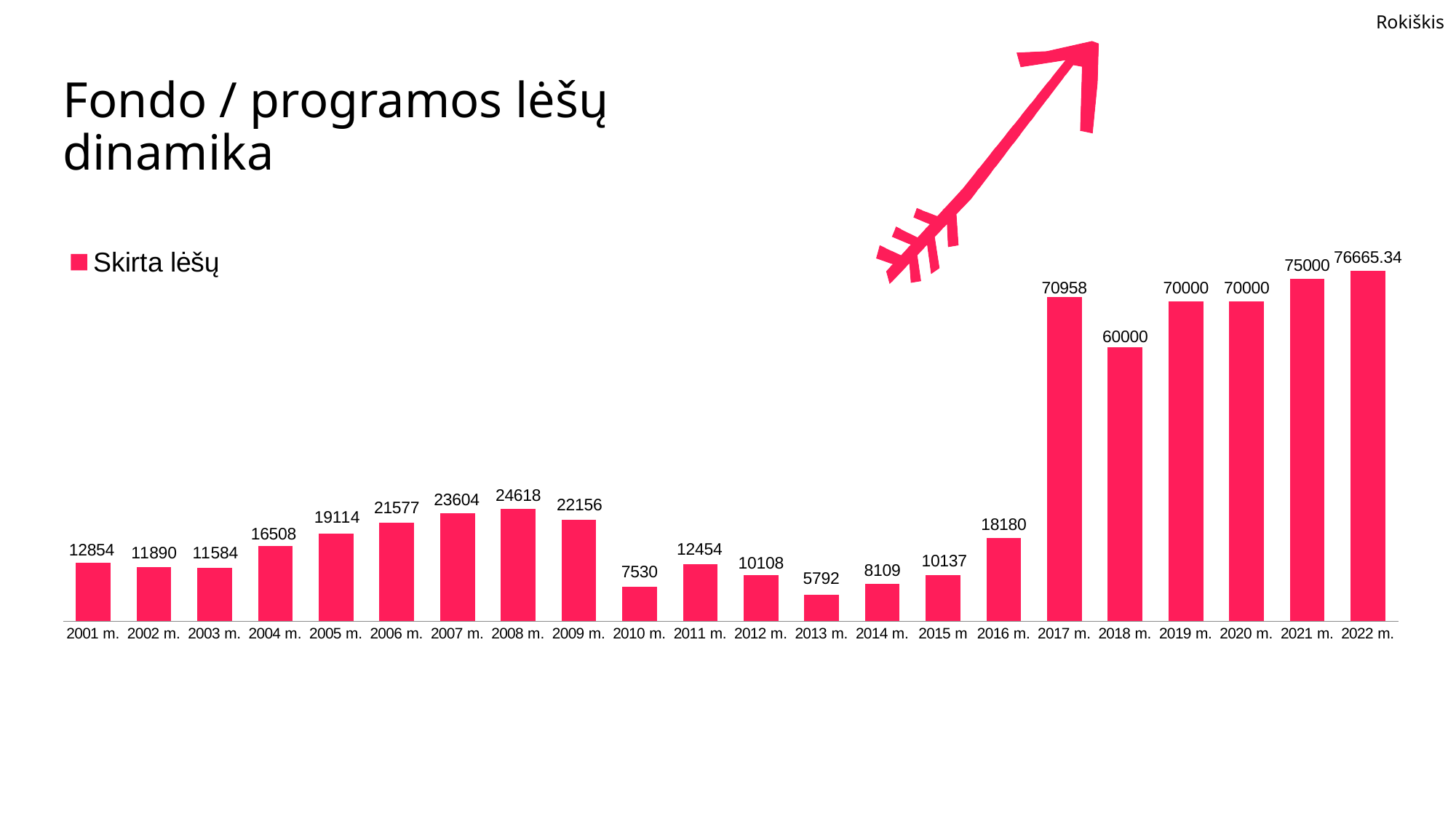
Which year has the lowest value? 2013 m. What value is shown for 2022 m.? 76665.34 Do the values rise or fall from 2013 m. to 2017 m.? Rise What value is shown for 2017 m.? 70958 Which is larger, the value for 2005 m. or the value for 2011 m.? 2005 m. What is the difference between the values for 2008 m. and 2007 m.? 1014 Which year has the highest value? 2022 m. How many series does the legend list? 1 How many years are shown on the x axis? 22 What kind of chart is shown on the slide? Bar chart What value is shown for 2010 m.? 7530 What is the difference between the values for 2017 m. and 2016 m.? 52778